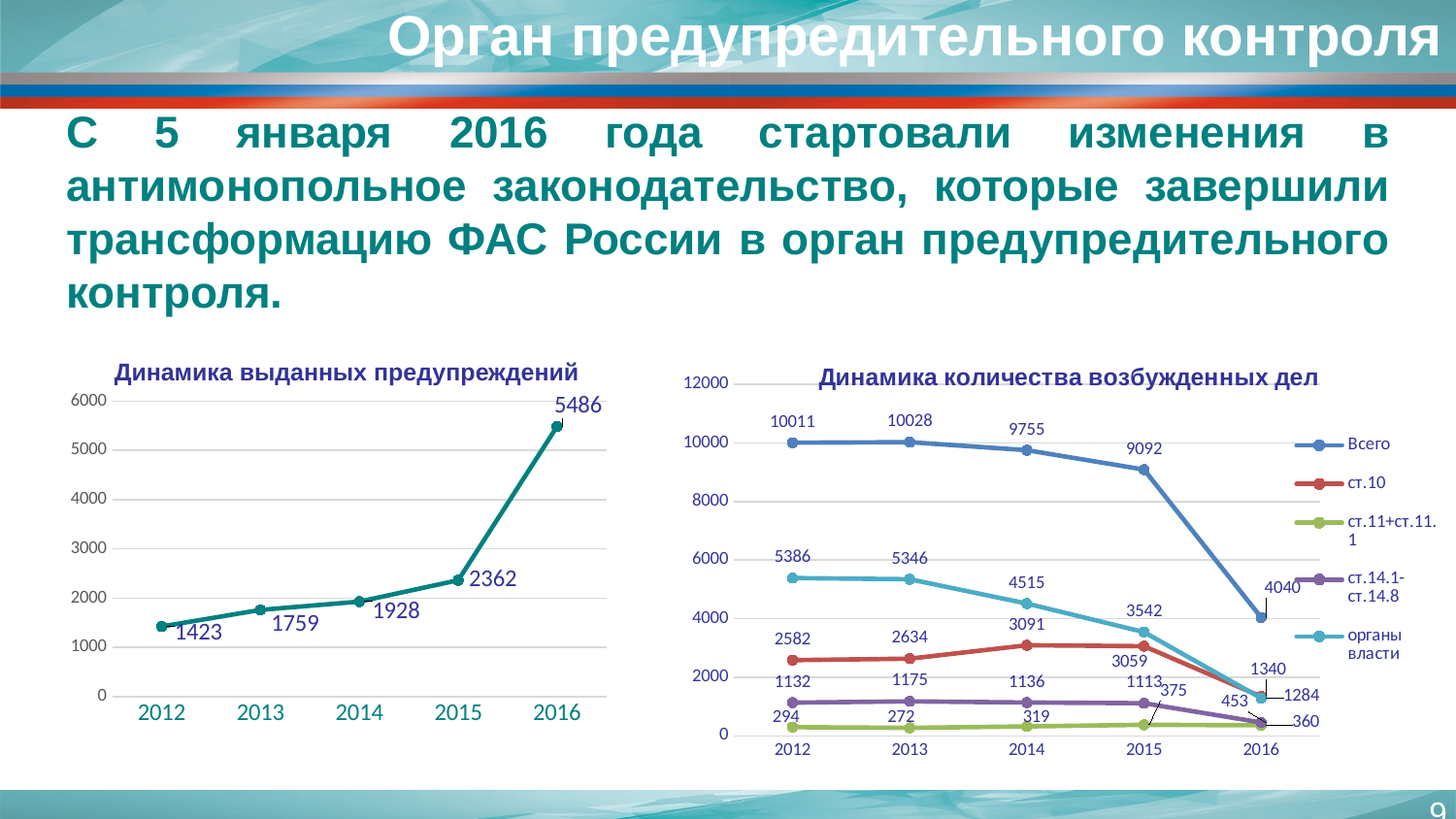
In the chart "Динамика количества возбужденных дел", which is larger in 2012: "ст.10" or "органы власти"? органы власти In the chart "Динамика выданных предупреждений", what is the difference between the 2016 and 2015 values? 3124 In the chart "Динамика количества возбужденных дел", what is the value of "органы власти" in 2014? 4515 In the chart "Динамика количества возбужденных дел", what is the value of "Всего" in 2013? 10028 What type of chart is the left chart titled "Динамика выданных предупреждений"? line chart In the chart "Динамика выданных предупреждений", what is the value for 2012? 1423 In the chart "Динамика количества возбужденных дел", what is the value of "ст.10" in 2014? 3091 In the chart "Динамика выданных предупреждений", which year has the highest value? 2016 How many series does the legend of the chart "Динамика количества возбужденных дел" list? 5 In the chart "Динамика выданных предупреждений", what is the value for 2016? 5486 In the chart "Динамика количества возбужденных дел", what is the difference between the "Всего" values for 2015 and 2016? 5052 In the chart "Динамика выданных предупреждений", do the values rise or fall from 2012 to 2016? rise